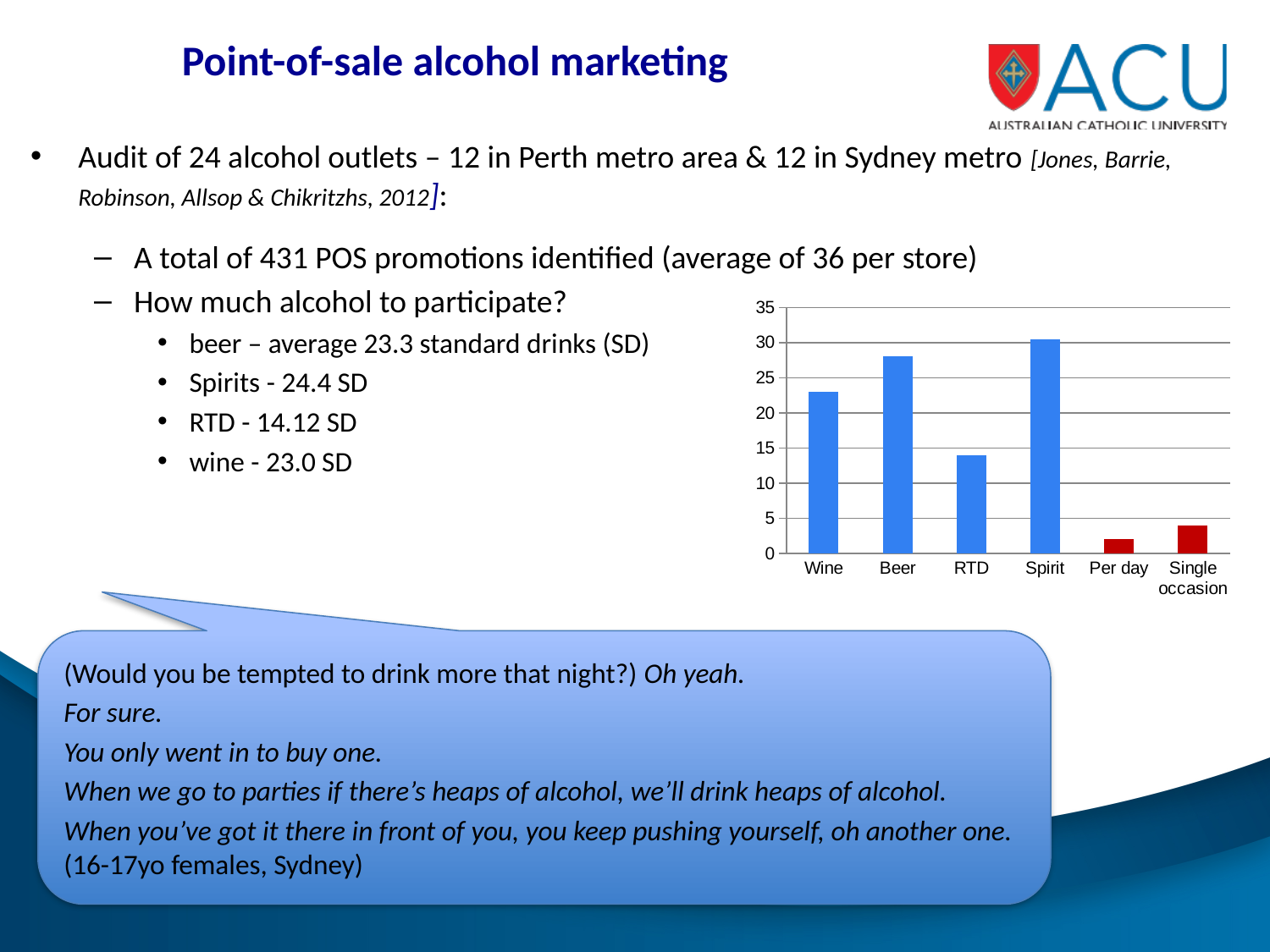
What colour are the bars for Per day and Single occasion in the chart? red Is the value for Wine greater or less than 20? greater Which category has the lowest bar in the chart? Per day Which is larger in the chart, the bar for RTD or the bar for Single occasion? RTD How many categories are shown on the x axis of the chart? 6 Is the value for RTD greater or less than 10? greater Is the value for Per day greater or less than 5? less Which is larger in the chart, the bar for Beer or the bar for Wine? Beer What kind of chart is shown on the slide? bar chart Which category has the highest bar in the chart? Spirit